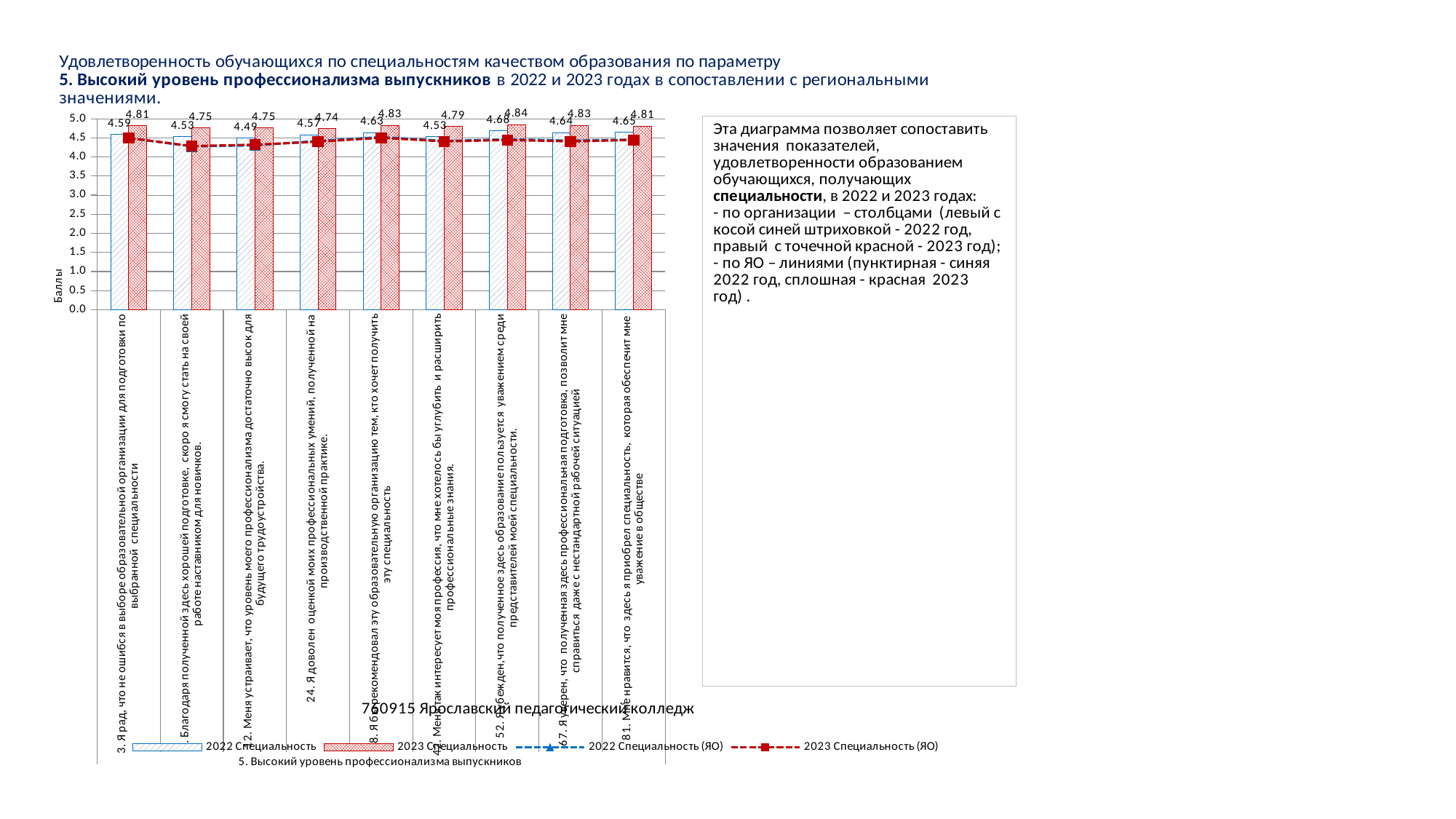
What is the label of the vertical axis? Баллы What is the 2023 Специальность value for statement 8 ("Я бы рекомендовал эту образовательную организацию...")? 4.83 What is the difference between the 2023 and 2022 Специальность values for statement 2 ("Меня устраивает, что уровень моего профессионализма...")? 0.26 What is the 2023 Специальность value for statement 24 ("Я доволен оценкой моих профессиональных умений...")? 4.74 What kind of chart is this? Bar chart (with line series) How many series does the legend list? 4 Which statement has the highest 2023 Специальность value? 52. Я убежден, что полученное здесь образование пользуется уважением среди представителей моей специальности (4.84) Which is larger: the 2022 Специальность value for statement 8 or for statement 24? Statement 8 (4.63) How many statements (categories) are shown on the x axis? 9 Which statement has the lowest 2022 Специальность value? 2. Меня устраивает, что уровень моего профессионализма достаточно высок для будущего трудоустройства (4.49) What is the 2022 Специальность value for statement 3 ("Я рад, что не ошибся в выборе образовательной организации...")? 4.59 Which statement has the lowest 2023 Специальность value? 24. Я доволен оценкой моих профессиональных умений, полученной на производственной практике (4.74)